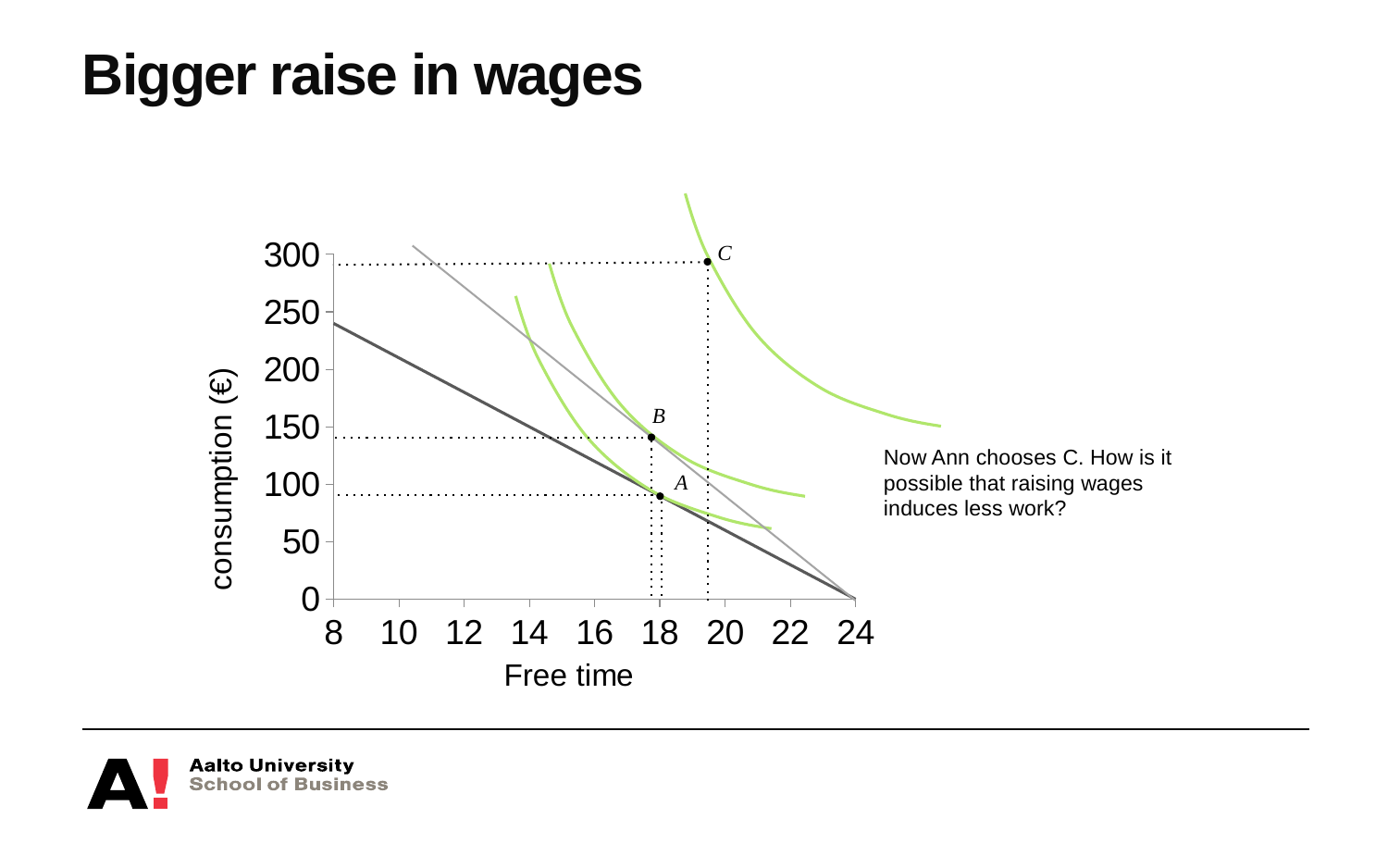
Is the free time at point C greater or less than 18? greater How many labeled points (A, B, C) are marked on the chart? 3 What is the label of the vertical axis? consumption (€) Is the consumption at point B greater or less than 100? greater Is the consumption at point A greater or less than 100? less What kind of chart is shown on the slide? line chart Which labeled point has the lowest consumption? A Which labeled point has the highest consumption? C Which labeled point has the most free time? C Which labeled point has more consumption, A or B? B At what value of free time do the budget lines meet the horizontal axis? 24